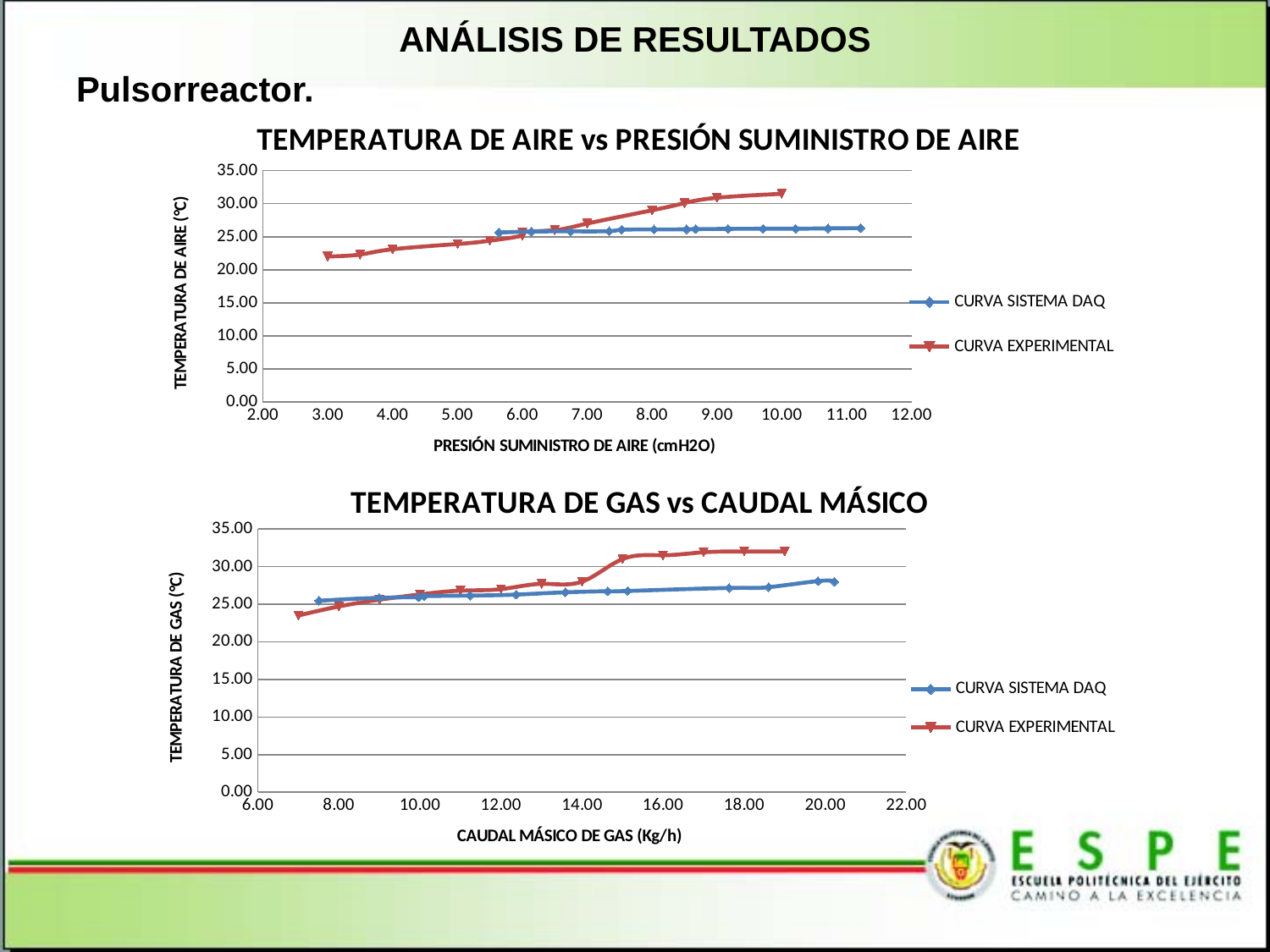
In the top chart, 'TEMPERATURA DE AIRE vs PRESIÓN SUMINISTRO DE AIRE', is the CURVA EXPERIMENTAL value at a pressure of 10.00 greater or less than 30.00? greater What type of chart is the bottom chart, 'TEMPERATURA DE GAS vs CAUDAL MÁSICO'? Line chart How many series does the legend of the top chart, 'TEMPERATURA DE AIRE vs PRESIÓN SUMINISTRO DE AIRE', list? 2 In the top chart, 'TEMPERATURA DE AIRE vs PRESIÓN SUMINISTRO DE AIRE', what is the label of the x axis? PRESIÓN SUMINISTRO DE AIRE (cmH2O) In the bottom chart, 'TEMPERATURA DE GAS vs CAUDAL MÁSICO', which series has the higher value at a mass flow of 18.00, CURVA SISTEMA DAQ or CURVA EXPERIMENTAL? CURVA EXPERIMENTAL In the top chart, 'TEMPERATURA DE AIRE vs PRESIÓN SUMINISTRO DE AIRE', does the CURVA EXPERIMENTAL series rise or fall as pressure increases? rise In the bottom chart, 'TEMPERATURA DE GAS vs CAUDAL MÁSICO', is the CURVA SISTEMA DAQ value at a mass flow of 20.00 greater or less than 30.00? less In the bottom chart, 'TEMPERATURA DE GAS vs CAUDAL MÁSICO', what is the label of the x axis? CAUDAL MÁSICO DE GAS (Kg/h) In the bottom chart, 'TEMPERATURA DE GAS vs CAUDAL MÁSICO', is the CURVA EXPERIMENTAL value at a mass flow of 19.00 greater or less than 30.00? greater What type of chart is the top chart, 'TEMPERATURA DE AIRE vs PRESIÓN SUMINISTRO DE AIRE'? Line chart In the top chart, 'TEMPERATURA DE AIRE vs PRESIÓN SUMINISTRO DE AIRE', which series has the higher value at a pressure of 10.00, CURVA SISTEMA DAQ or CURVA EXPERIMENTAL? CURVA EXPERIMENTAL